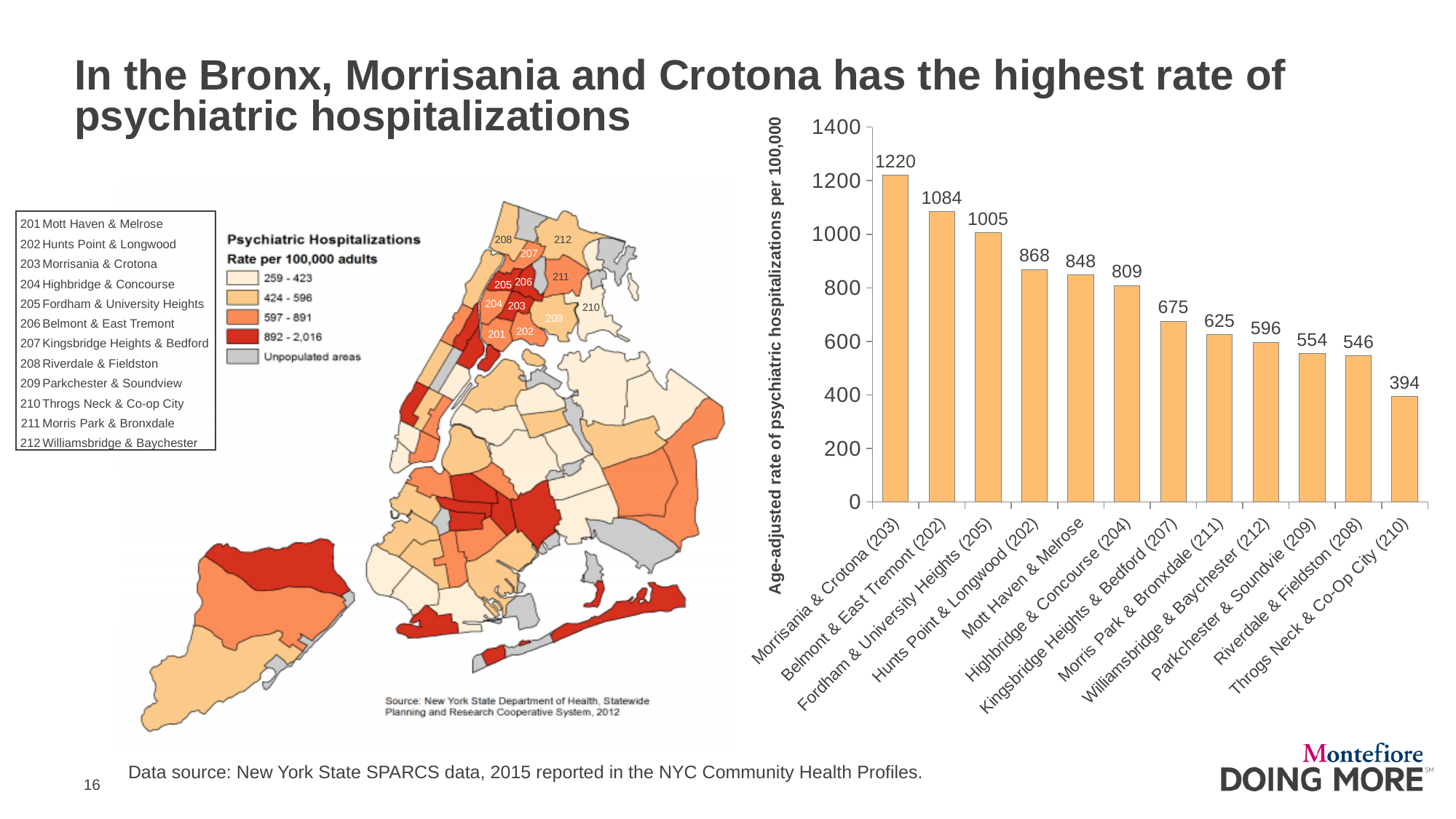
On the bar chart, which neighborhood has the lowest rate of psychiatric hospitalizations? Throgs Neck & Co-Op City (210) On the bar chart, what is the value for Highbridge & Concourse (204)? 809 On the bar chart, what is the value for Riverdale & Fieldston (208)? 546 On the bar chart, is the value for Williamsbridge & Baychester (212) greater or less than 800? less On the bar chart, what is the difference between the values for Belmont & East Tremont (202) and Fordham & University Heights (205)? 79 What kind of chart is shown on the right side of the slide? bar chart On the bar chart, what is the age-adjusted rate of psychiatric hospitalizations per 100,000 for Morrisania & Crotona (203)? 1220 On the bar chart, which neighborhood has the highest rate of psychiatric hospitalizations? Morrisania & Crotona (203) On the bar chart, do the values rise or fall from left to right along the x axis? fall On the bar chart, what is the difference between the values for Morrisania & Crotona (203) and Throgs Neck & Co-Op City (210)? 826 On the bar chart, which has a higher value: Kingsbridge Heights & Bedford (207) or Morris Park & Bronxdale (211)? Kingsbridge Heights & Bedford (207) How many neighborhoods are shown on the bar chart? 12